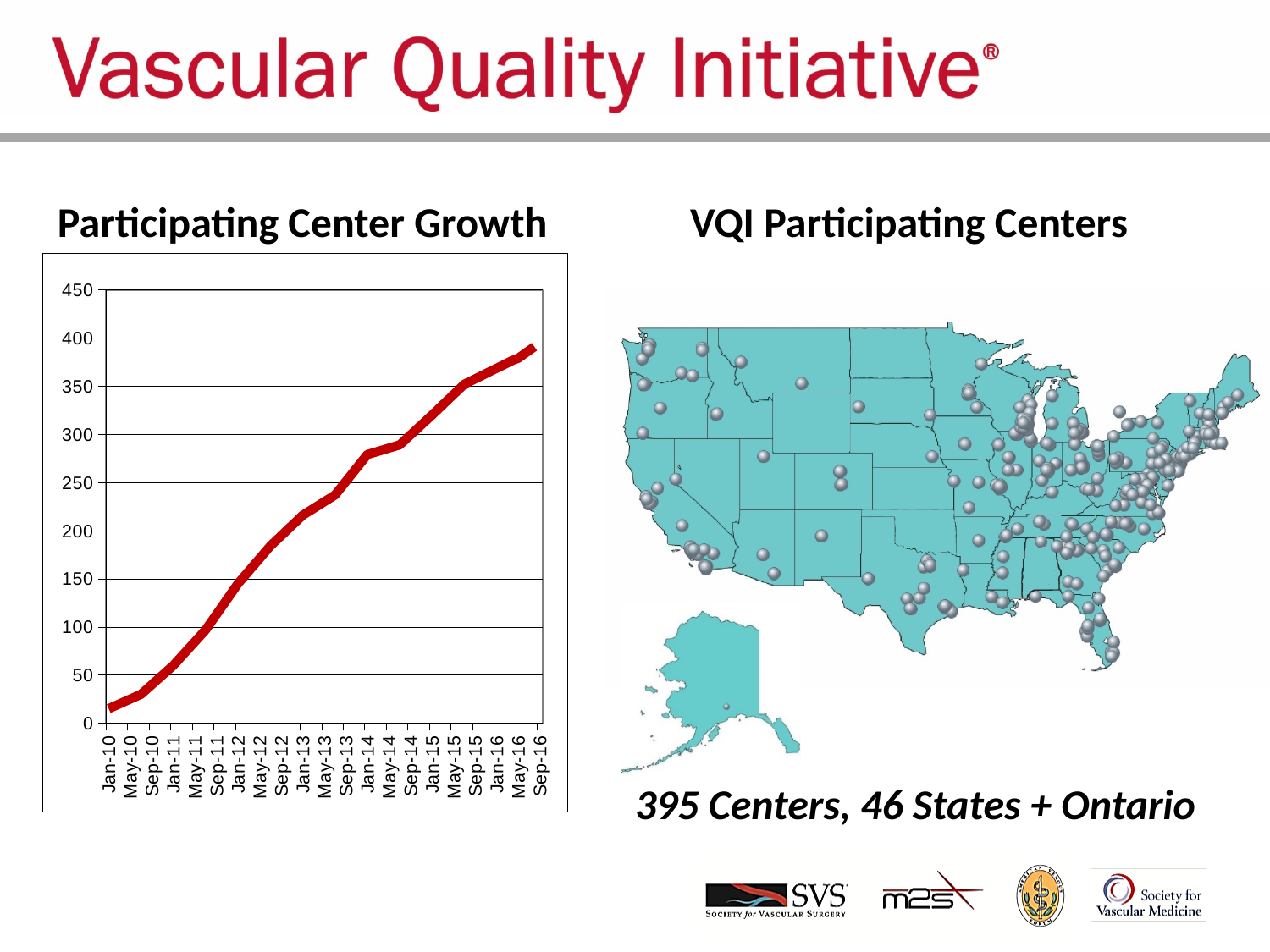
In the Participating Center Growth chart, which x-axis point has the highest value? Sep-16 In the Participating Center Growth chart, is the value for May-11 greater or less than 100? less In the Participating Center Growth chart, which is larger, the value for Sep-14 or the value for Sep-11? Sep-14 In the Participating Center Growth chart, which x-axis point has the lowest value? Jan-10 In the Participating Center Growth chart, is the value for Jan-16 greater or less than 350? greater What is the highest value shown on the y-axis of the Participating Center Growth chart? 450 In the Participating Center Growth chart, is the value for Sep-16 greater or less than 350? greater In the Participating Center Growth chart, do the values rise or fall from Jan-10 to Sep-16? rise What kind of chart is the Participating Center Growth chart? line chart How many x-axis labels are shown on the Participating Center Growth chart? 21